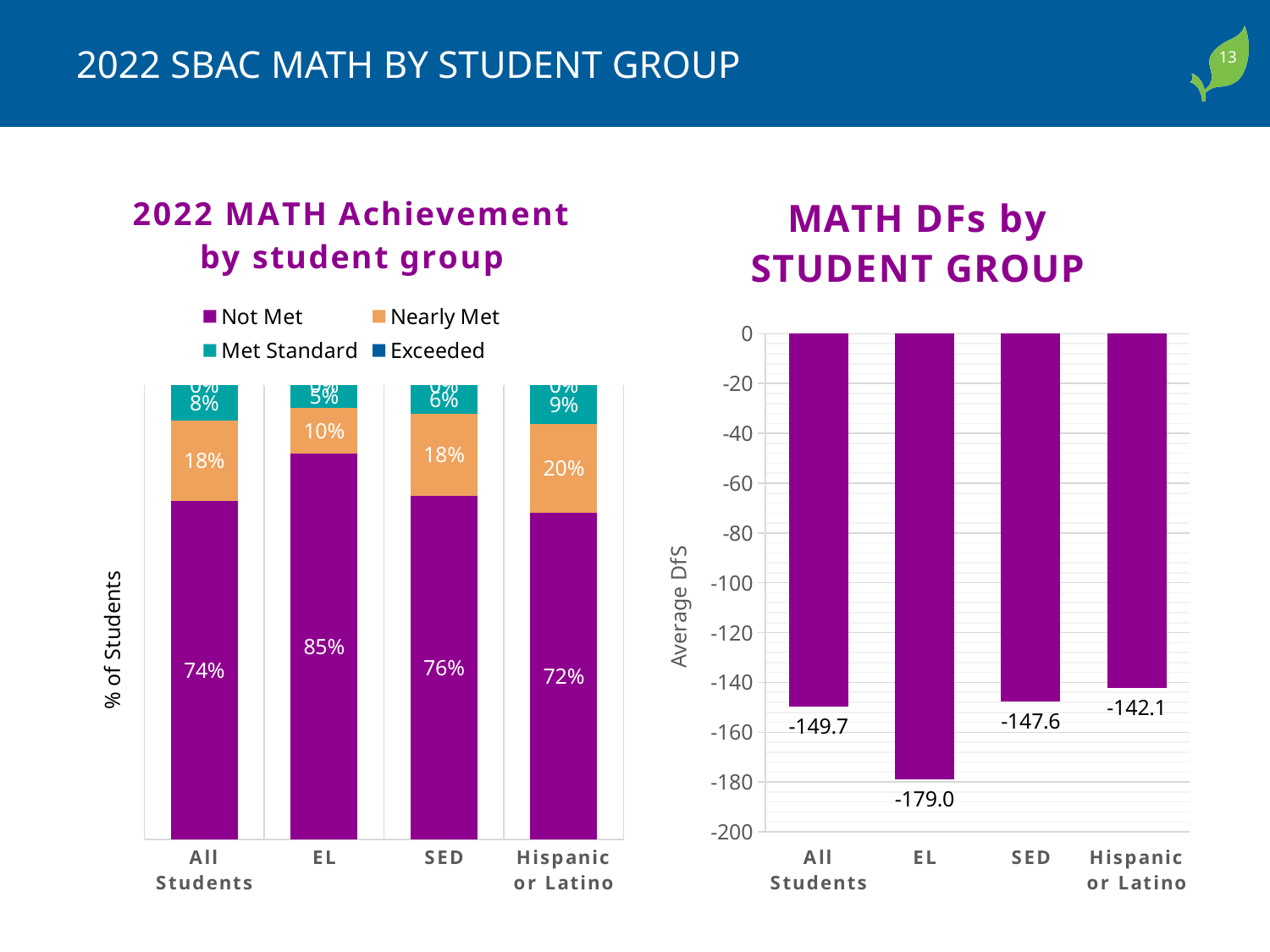
In the '2022 MATH Achievement by student group' chart, what is the Nearly Met percentage for Hispanic or Latino students? 20% In the '2022 MATH Achievement by student group' chart, what percentage of All Students are in the Not Met category? 74% In the '2022 MATH Achievement by student group' chart, how many series does the legend list? 4 In the '2022 MATH Achievement by student group' chart, what is the Met Standard percentage for SED students? 6% In the 'MATH DFs by STUDENT GROUP' chart, what is the difference between the Average DfS for All Students and for SED? 2.1 In the 'MATH DFs by STUDENT GROUP' chart, which student group has the lowest Average DfS? EL In the 'MATH DFs by STUDENT GROUP' chart, how many student groups are shown on the x axis? 4 In the '2022 MATH Achievement by student group' chart, what is the difference between the Not Met percentage for EL and for All Students? 11% In the 'MATH DFs by STUDENT GROUP' chart, what is the Average DfS for EL students? -179.0 In the '2022 MATH Achievement by student group' chart, which student group has the highest Not Met percentage? EL What type of chart is the 'MATH DFs by STUDENT GROUP' chart? Bar chart In the 'MATH DFs by STUDENT GROUP' chart, which student group has the highest Average DfS? Hispanic or Latino